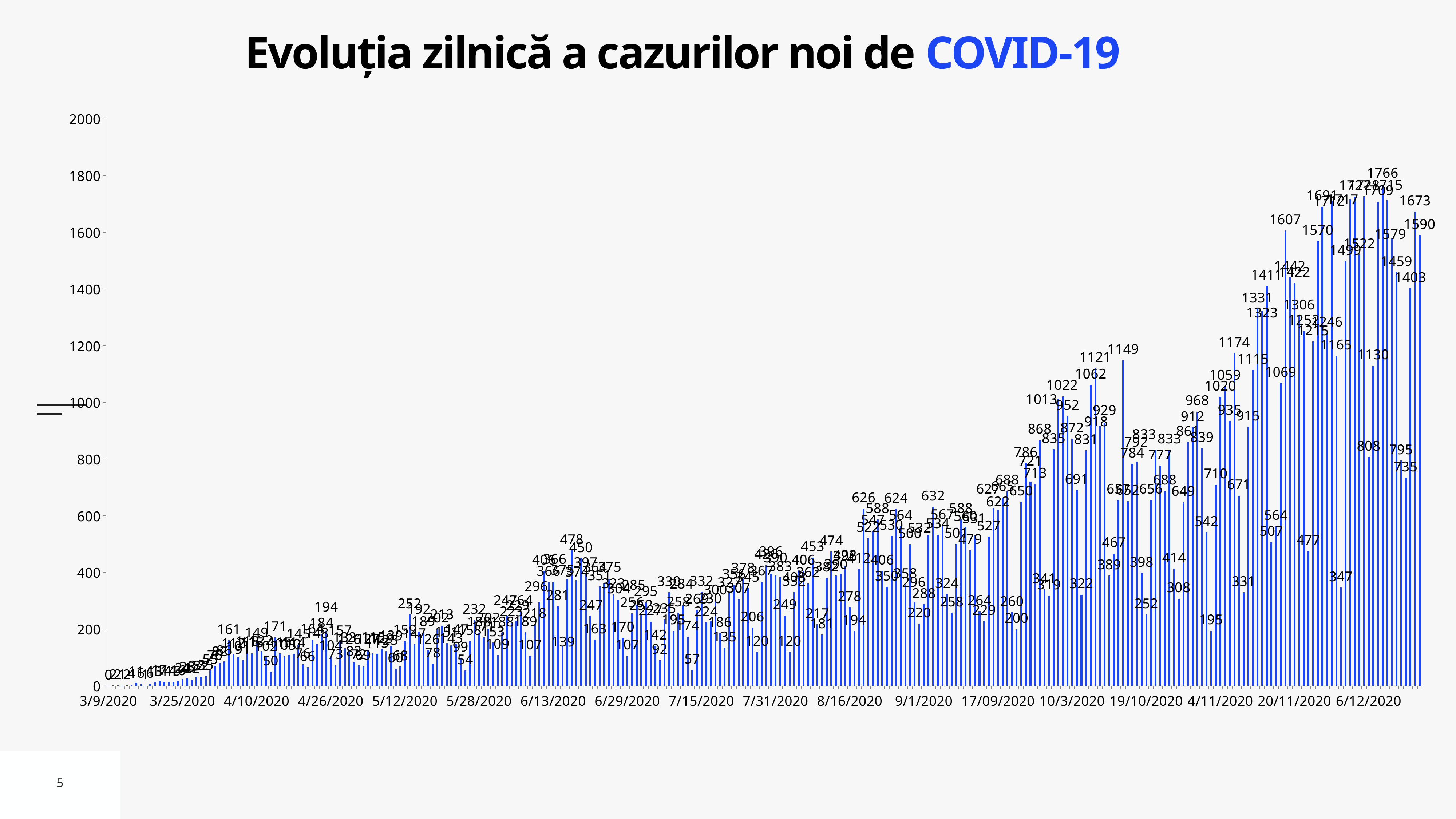
What is the maximum value shown on the y axis? 2000 What is the value of the rightmost (last) bar on the chart? 1590 What is the value for 3/9/2020, the first date on the x axis? 0 What is the title of the chart? Evoluția zilnică a cazurilor noi de COVID-19 What kind of chart is shown on the slide? bar chart Is the highest value on the chart greater or less than 1800? less Which is higher: the tallest bar in June 2020 or the tallest bar in December 2020? December 2020 Is the value for 3/9/2020 greater or less than 200? less Overall, do the values rise or fall from left to right along the x axis? rise What is the difference between the highest value (1766) and the value of the rightmost bar (1590)? 176 What is the highest value labeled on the chart? 1766